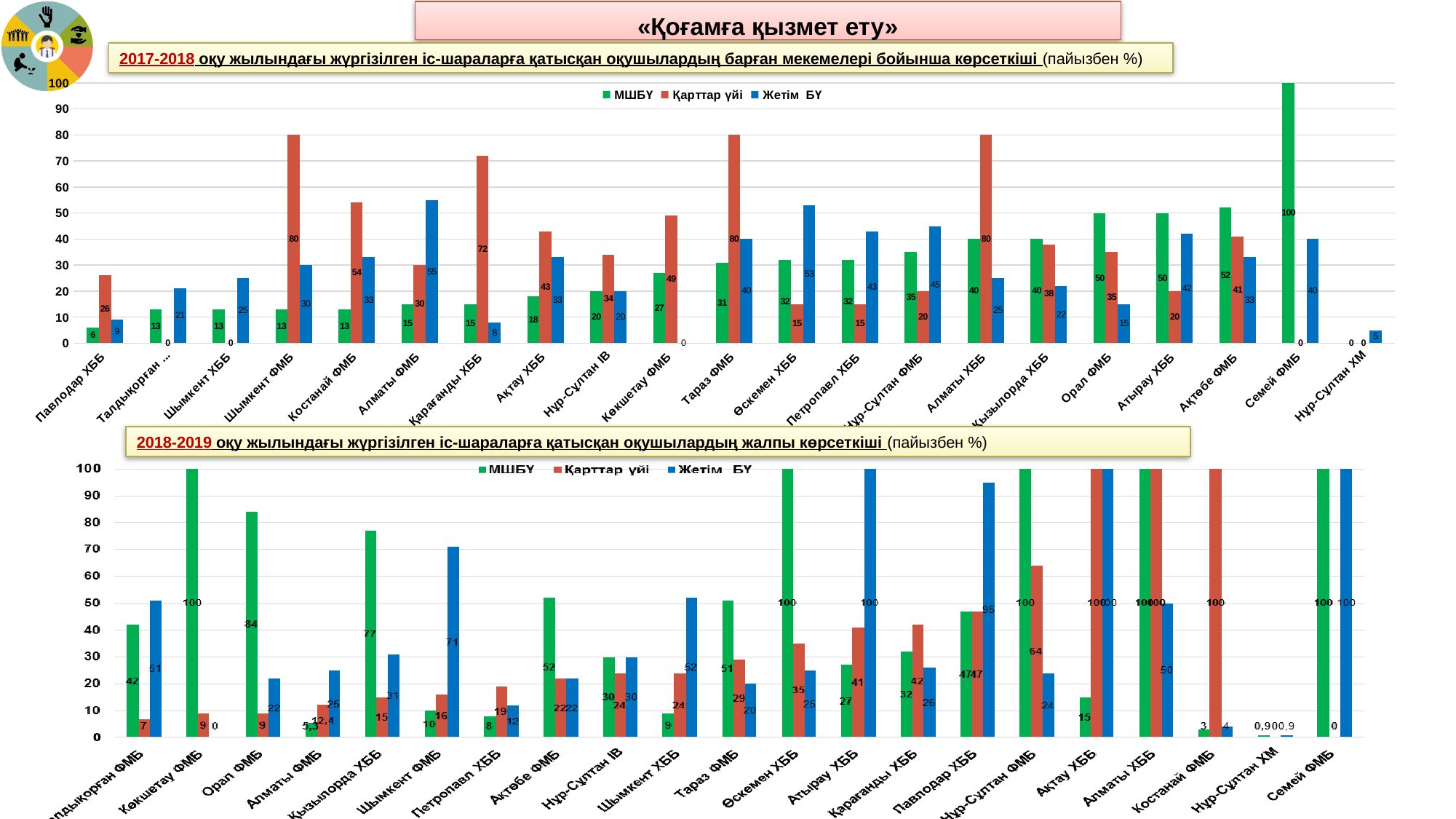
In the bottom chart (2018-2019), what is the value for Қарттар үйі at Нұр-Сұлтан ФМБ? 64 How many categories are shown on the x axis of the bottom chart (2018-2019)? 21 In the top chart (2017-2018), what is the value for Жетім БҮ at Алматы ФМБ? 55 In the bottom chart (2018-2019), which is larger at Атырау ХББ: the МШБҮ value or the Қарттар үйі value? Қарттар үйі In the top chart (2017-2018), what is the difference between the Қарттар үйі and МШБҮ values at Қарағанды ХББ? 57 In the bottom chart (2018-2019), what is the difference between the МШБҮ and Қарттар үйі values at Орал ФМБ? 75 In the bottom chart (2018-2019), what is the value for Жетім БҮ at Шымкент ФМБ? 71 What kind of chart is the bottom chart (2018-2019)? Bar chart In the top chart (2017-2018), which category has the highest МШБҮ value? Семей ФМБ In the top chart (2017-2018), what is the value for Қарттар үйі at Шымкент ФМБ? 80 How many series does the legend of the top chart (2017-2018) list? 3 In the top chart (2017-2018), which is larger at Өскемен ХББ: the МШБҮ value or the Жетім БҮ value? Жетім БҮ